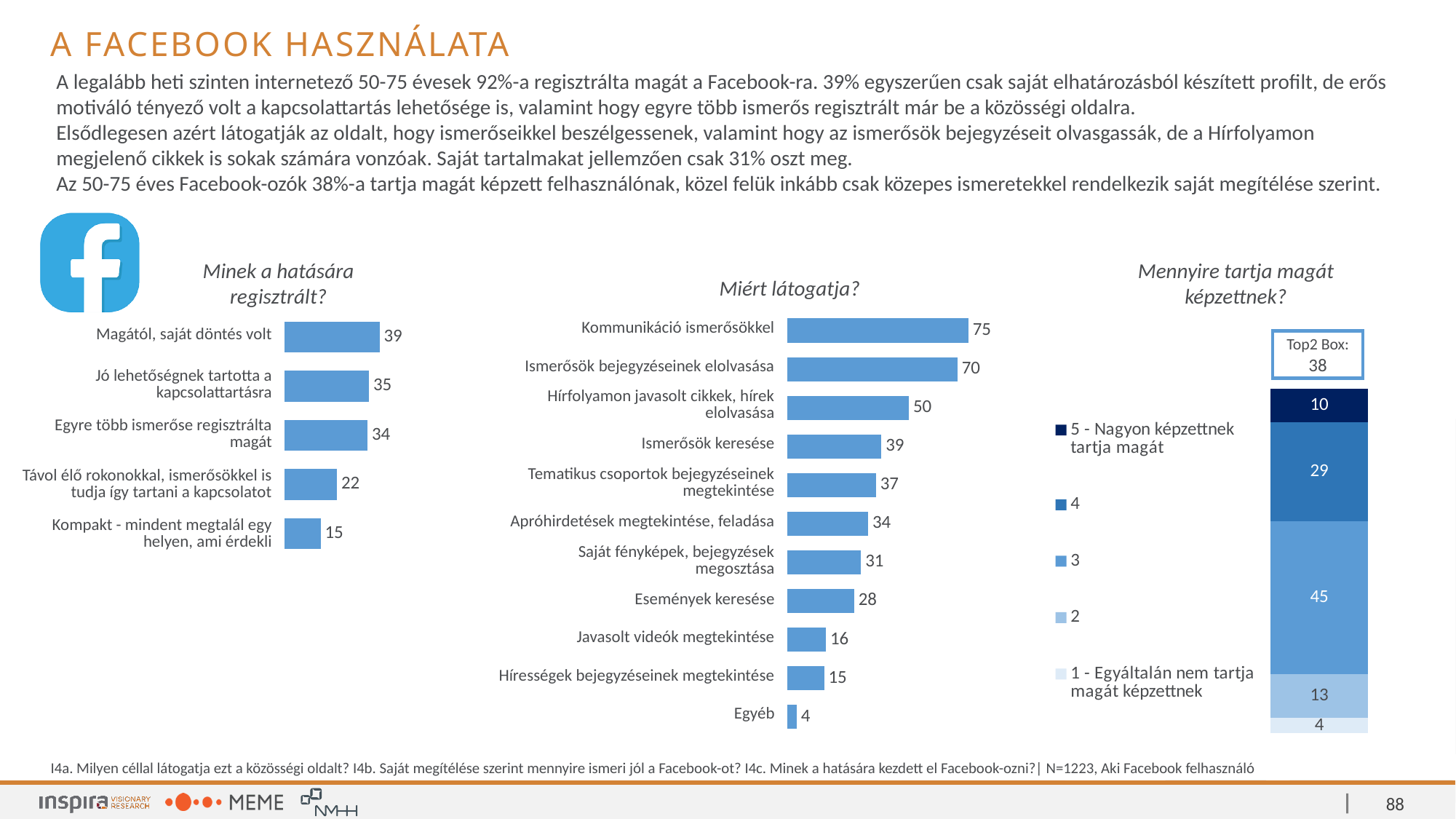
In the 'Mennyire tartja magát képzettnek?' chart, how many entries does the legend list? 5 In the 'Mennyire tartja magát képzettnek?' chart, what is the Top2 Box value shown? 38 In the 'Miért látogatja?' chart, which is larger: 'Események keresése' or 'Javasolt videók megtekintése'? Események keresése In the 'Miért látogatja?' chart, what is the difference between 'Kommunikáció ismerősökkel' and 'Hírfolyamon javasolt cikkek, hírek elolvasása'? 25 In the 'Miért látogatja?' chart, how many categories are shown? 11 In the 'Miért látogatja?' chart, what is the value for 'Ismerősök bejegyzéseinek elolvasása'? 70 In the 'Mennyire tartja magát képzettnek?' chart, what is the value for the segment '3'? 45 In the 'Miért látogatja?' chart, which category has the highest value? Kommunikáció ismerősökkel In the 'Minek a hatására regisztrált?' chart, what is the value for 'Magától, saját döntés volt'? 39 What kind of chart is the 'Miért látogatja?' chart? Bar chart In the 'Minek a hatására regisztrált?' chart, how many categories are shown? 5 In the 'Minek a hatására regisztrált?' chart, which category has the lowest value? Kompakt - mindent megtalál egy helyen, ami érdekli